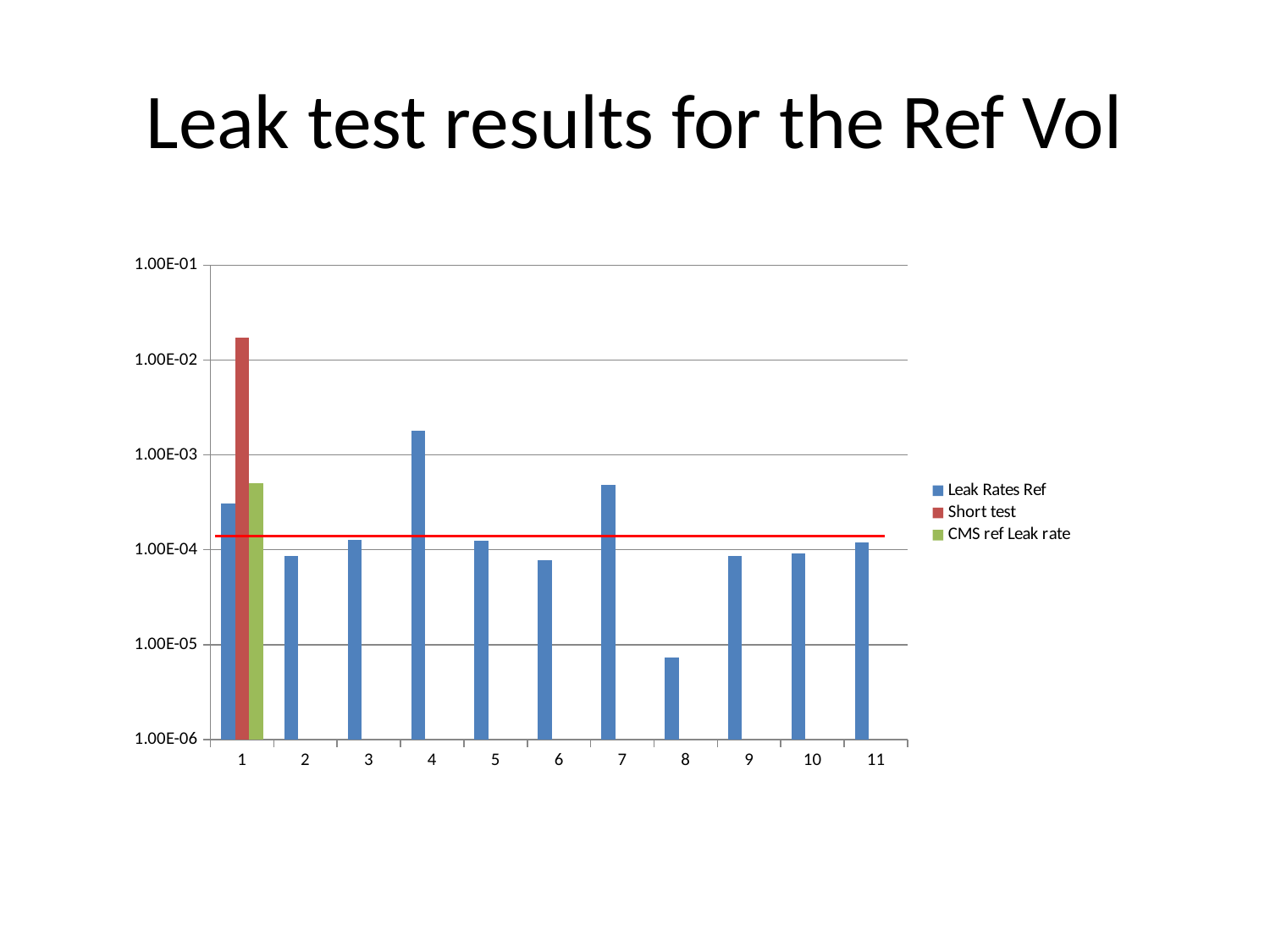
Is the Leak Rates Ref value for category 4 greater or less than 1.00E-03? greater What is the title of the slide containing the chart? Leak test results for the Ref Vol Which is larger for category 1, the Short test value or the CMS ref Leak rate value? Short test Is the Leak Rates Ref value for category 8 greater or less than 1.00E-05? less What kind of chart is shown on the slide? bar chart Which category has the lowest Leak Rates Ref value? 8 Which is larger, the Leak Rates Ref value for category 4 or for category 7? category 4 Is the Leak Rates Ref value for category 7 greater or less than 1.00E-04? greater Which category has the highest Leak Rates Ref value? 4 How many series does the legend list? 3 How many categories are shown along the x axis? 11